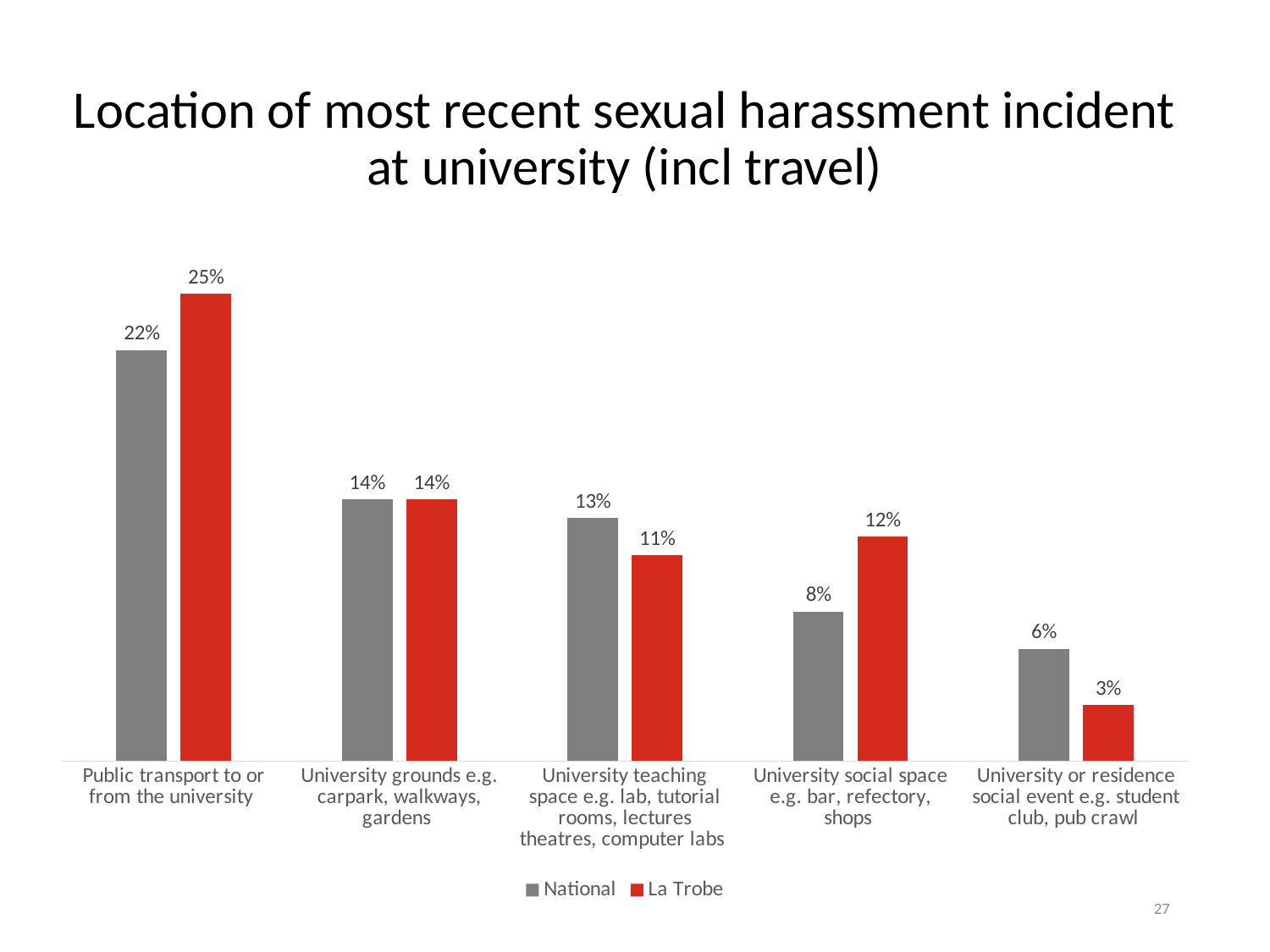
Which location has the lowest La Trobe value? University or residence social event e.g. student club, pub crawl What is the difference between the La Trobe and National values for Public transport to or from the university? 3% How many location categories are shown on the chart? 5 What is the National value for University social space e.g. bar, refectory, shops? 8% What is the difference between the National and La Trobe values for University teaching space e.g. lab, tutorial rooms, lectures theatres, computer labs? 2% For University social space e.g. bar, refectory, shops, which is larger: the National value or the La Trobe value? La Trobe Which colour represents the La Trobe series? Red Which location has the highest National value? Public transport to or from the university How many series does the legend list? 2 What is the La Trobe value for Public transport to or from the university? 25% What kind of chart is shown on the slide? Bar chart What is the La Trobe value for University or residence social event e.g. student club, pub crawl? 3%